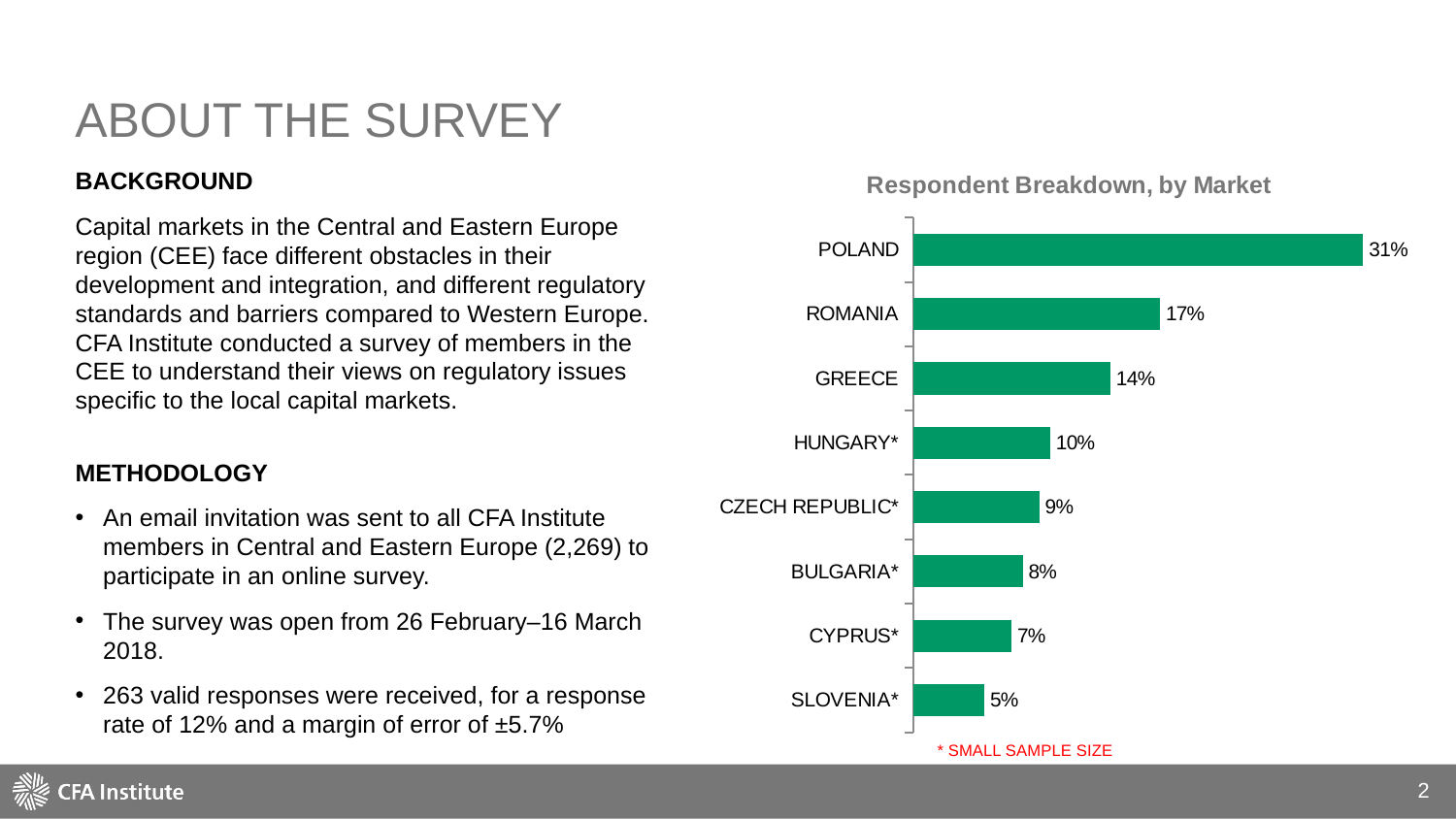
What type of chart is used to show the respondent breakdown? Bar chart How many markets are shown in the chart? 8 What share of respondents are from the Czech Republic? 9% Which has a larger share of respondents, Bulgaria or Slovenia? Bulgaria What is the difference between the values for Poland and Romania? 14% Which market has the lowest share of respondents? Slovenia Which market has the highest share of respondents? Poland What percentage of respondents are from Poland? 31% Which has a larger share of respondents, Romania or Greece? Romania What is the value shown for Greece? 14% What is the difference between the values for Hungary and Cyprus? 3% What is the title of the chart? Respondent Breakdown, by Market